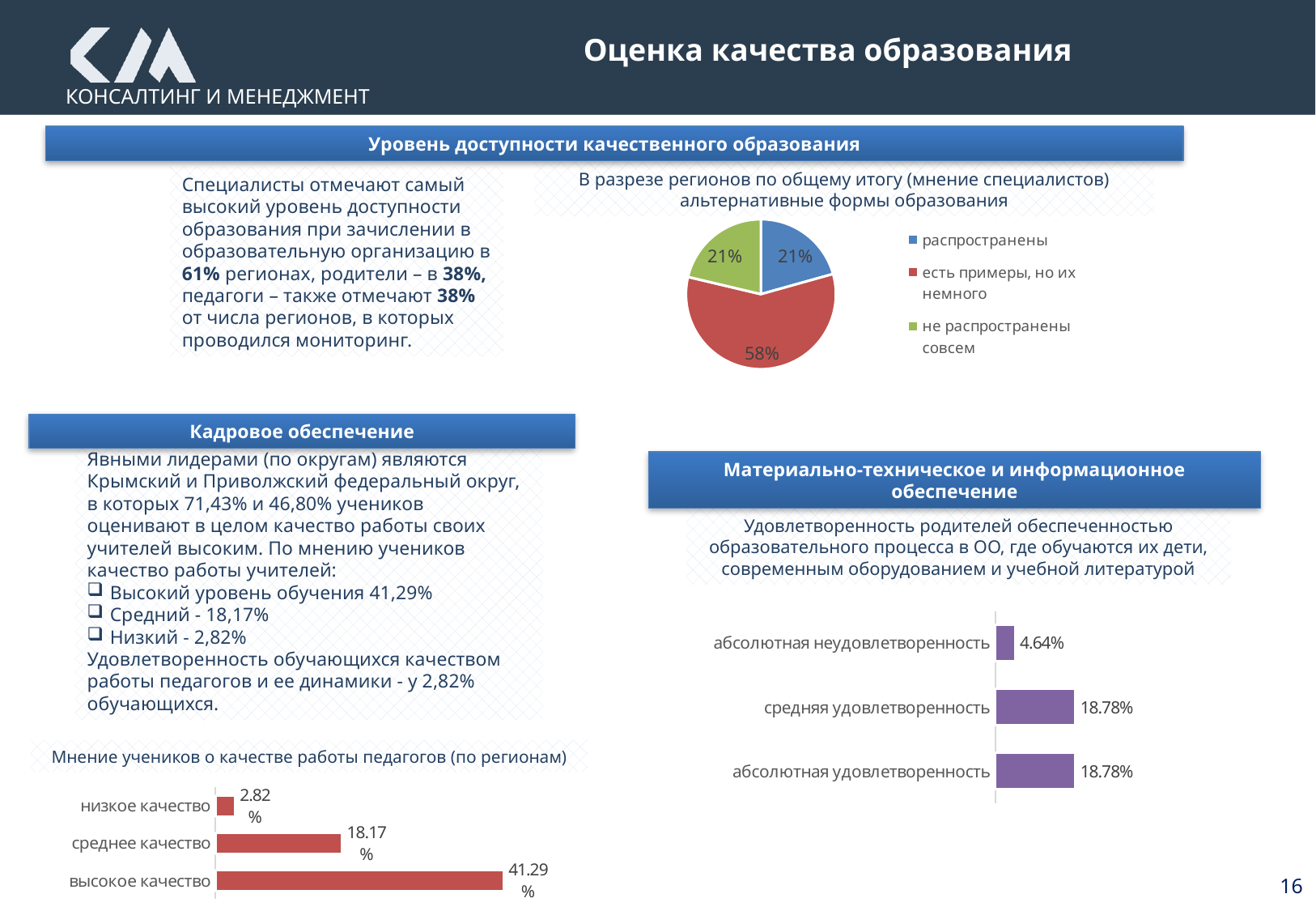
In the pie chart at the top right of the slide, which legend category has the largest slice? есть примеры, но их немного What type of chart is 'Мнение учеников о качестве работы педагогов (по регионам)'? bar chart In the pie chart at the top right of the slide, what colour is the slice for 'не распространены совсем'? green In the bar chart at the bottom right of the slide, which is larger: 'средняя удовлетворенность' or 'абсолютная неудовлетворенность'? средняя удовлетворенность In the chart 'Мнение учеников о качестве работы педагогов (по регионам)', what is the difference between 'высокое качество' and 'низкое качество'? 38.47% In the chart 'Мнение учеников о качестве работы педагогов (по регионам)', what is the value for 'среднее качество'? 18.17% How many categories are shown in the bar chart at the bottom right of the slide? 3 How many categories does the legend of the pie chart at the top right of the slide list? 3 In the bar chart at the bottom right of the slide, what is the value for 'абсолютная неудовлетворенность'? 4.64% In the chart 'Мнение учеников о качестве работы педагогов (по регионам)', which category has the lowest value? низкое качество In the pie chart at the top right of the slide, what share is labelled for the slice 'есть примеры, но их немного'? 58% In the pie chart at the top right of the slide, what is the difference between the share for 'есть примеры, но их немного' and the share for 'распространены'? 37%